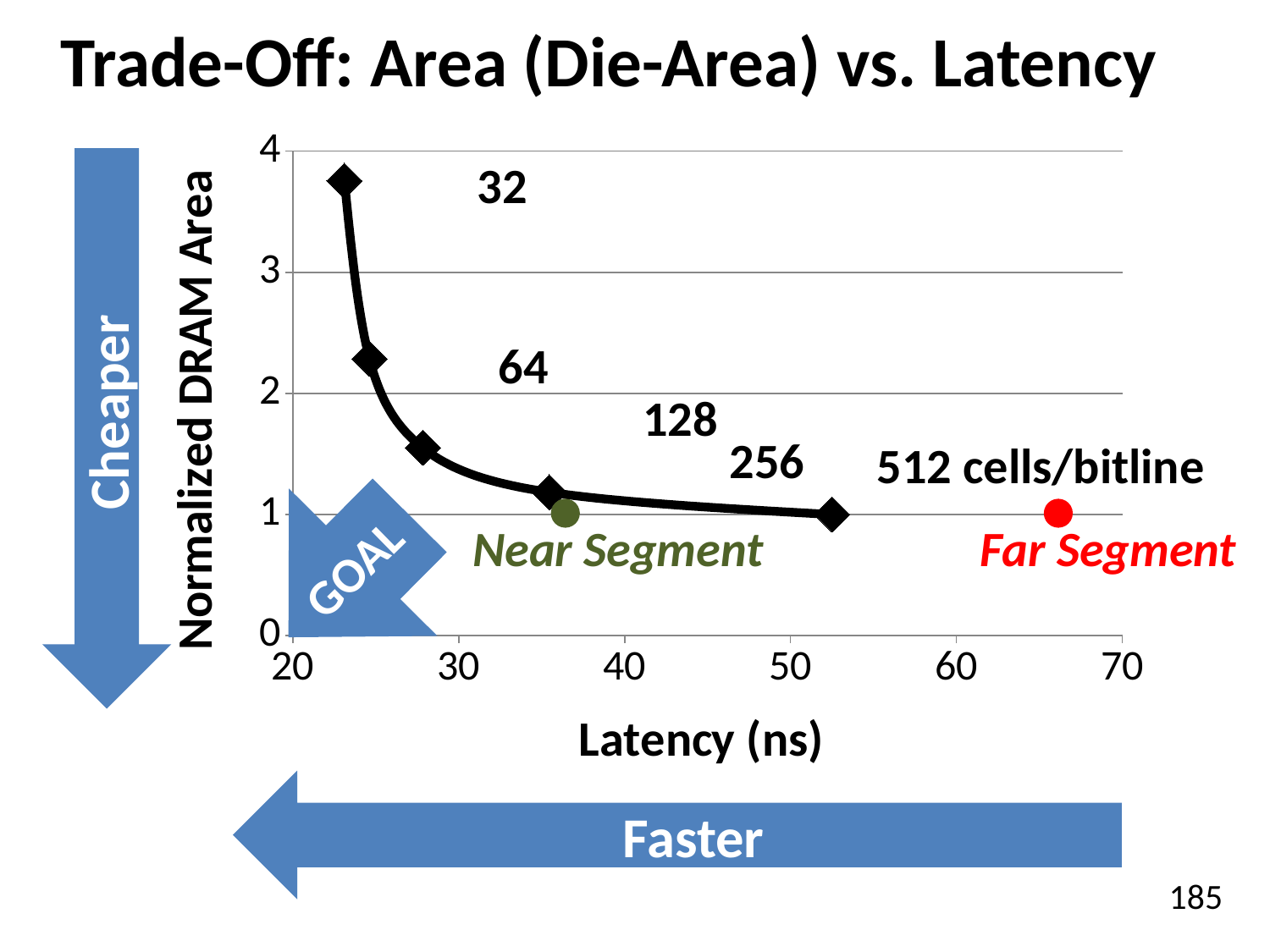
Is the latency for 512 cells/bitline greater or less than 50 ns? greater Is the normalized DRAM area for 64 cells/bitline greater or less than 2? greater How many data points are plotted on the black curve? 5 Which has a higher normalized DRAM area, 64 cells/bitline or 256 cells/bitline? 64 cells/bitline What type of chart is shown on the slide? line chart What is the label of the x axis? Latency (ns) Which cells/bitline configuration has the lowest normalized DRAM area? 512 What is the label of the y axis? Normalized DRAM Area As latency increases along the x axis, does the normalized DRAM area rise or fall? fall Which cells/bitline configuration has the highest normalized DRAM area? 32 Is the normalized DRAM area for 32 cells/bitline greater or less than 3? greater